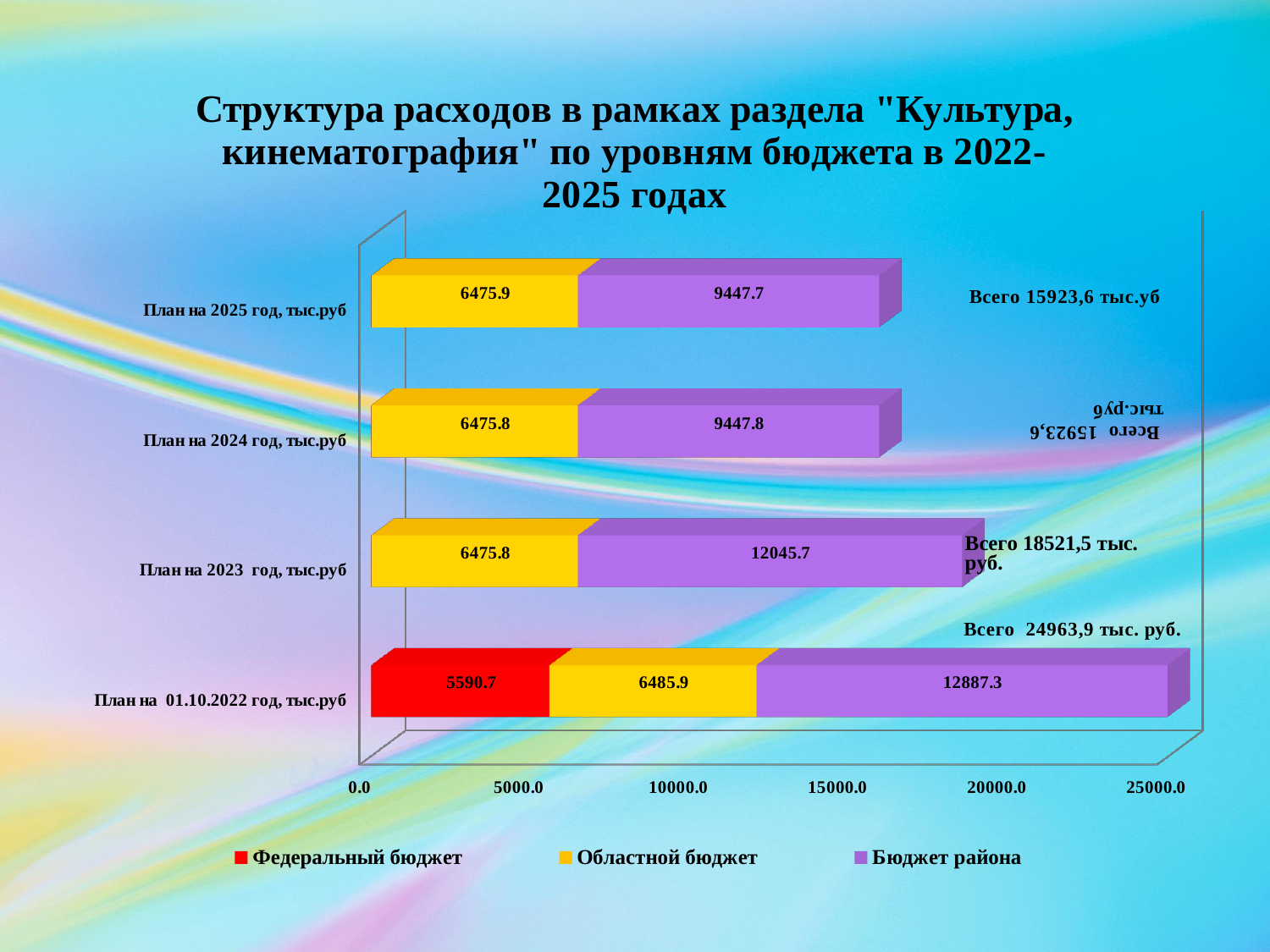
What is the value of Федеральный бюджет for План на 01.10.2022 год, тыс.руб? 5590.7 What colour represents Федеральный бюджет in the legend? Red Is the total length of the bar for План на 2025 год greater or less than 15000.0? greater Which category has the highest value for Бюджет района? План на 01.10.2022 год, тыс.руб Which is larger: the Областной бюджет value for План на 01.10.2022 год or for План на 2025 год? План на 01.10.2022 год What is the difference between the Бюджет района values for План на 2023 год and План на 2024 год? 2597.9 How many categories are shown on the chart? 4 What is the value of Бюджет района for План на 2023 год, тыс.руб? 12045.7 What kind of chart is shown on the slide? Stacked bar chart What is the total of the stacked bar for План на 01.10.2022 год, тыс.руб? 24963.9 How many series does the legend list? 3 What is the value of Областной бюджет for План на 2025 год, тыс.руб? 6475.9